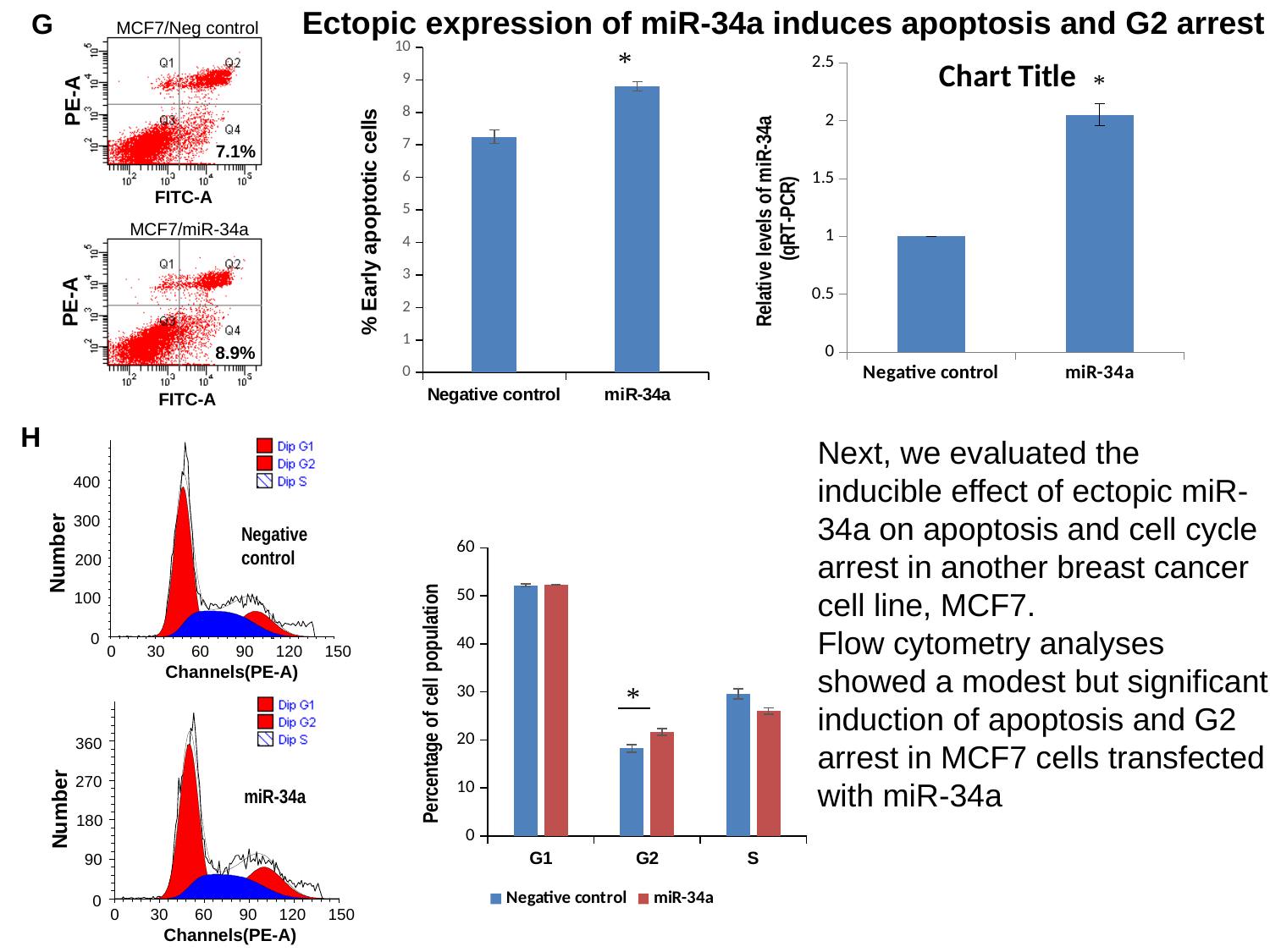
How many cell cycle phase categories are shown on the x axis of the 'Percentage of cell population' chart? 3 In the '% Early apoptotic cells' chart, which group has the higher value, Negative control or miR-34a? miR-34a How many series does the legend of the 'Percentage of cell population' chart list? 2 What kind of chart is the '% Early apoptotic cells' chart at the top middle of the slide? bar chart In the 'Percentage of cell population' chart, is the Negative control value for G1 greater or less than 50? greater In the '% Early apoptotic cells' chart, is the value for Negative control greater or less than 8? less In the chart titled 'Chart Title' (relative levels of miR-34a), is the value for miR-34a greater or less than 1.5? greater In the chart titled 'Chart Title' (relative levels of miR-34a), what is the value for Negative control? 1 In the chart titled 'Chart Title', which group has the higher relative level of miR-34a? miR-34a In the 'Percentage of cell population' chart, for G2, which series has the larger value, Negative control or miR-34a? miR-34a In the 'Percentage of cell population' chart, for S, which series has the larger value, Negative control or miR-34a? Negative control